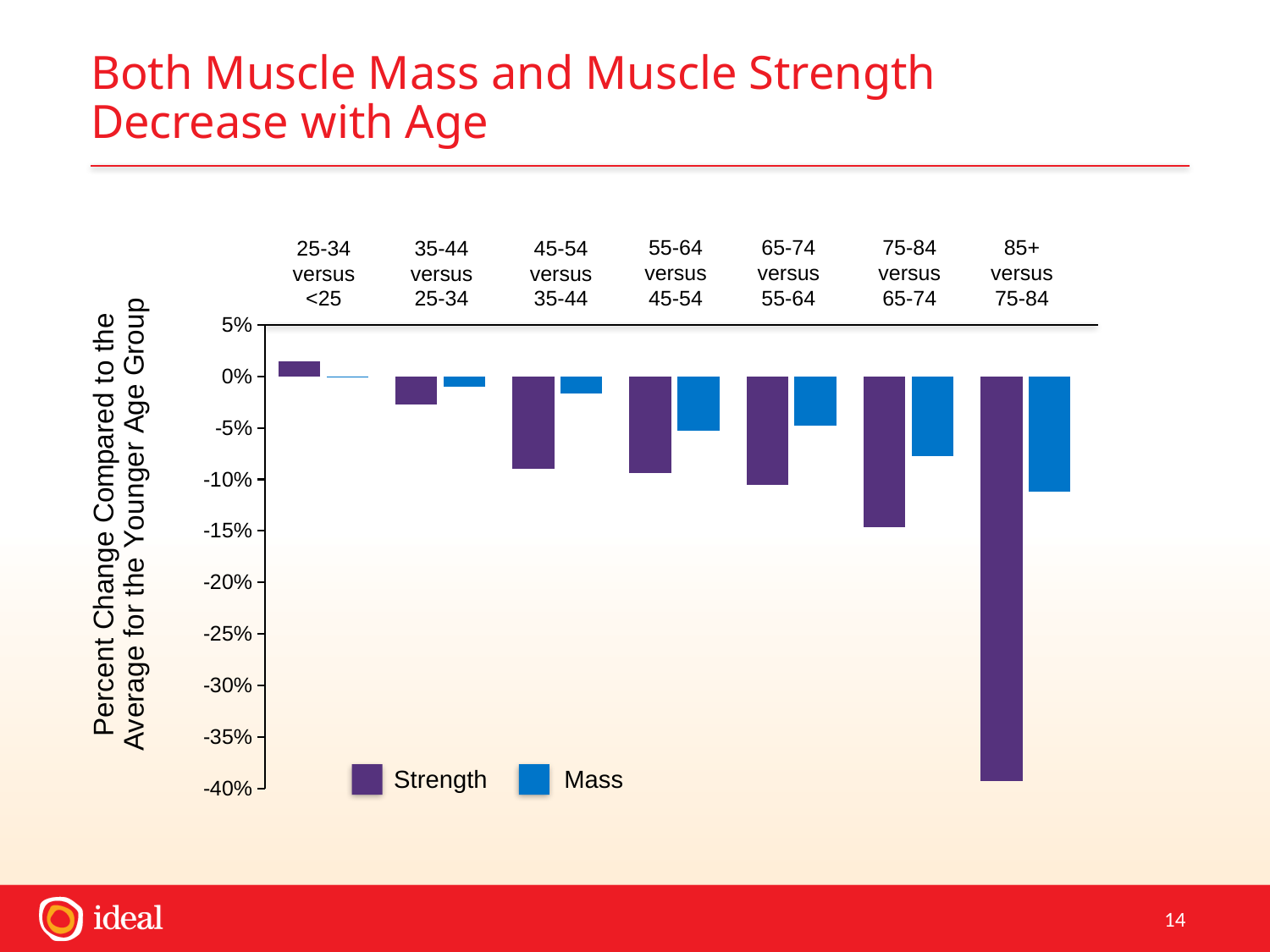
Which age-group comparison has the lowest Strength value? 85+ versus 75-84 Which age-group comparison has the lowest Mass value? 85+ versus 75-84 For 85+ versus 75-84, which series shows the larger decrease, Strength or Mass? Strength Is the Mass value for 35-44 versus 25-34 greater or less than -5%? greater Which age-group comparison has the highest Strength value? 25-34 versus <25 Is the Strength value for 85+ versus 75-84 greater or less than -35%? less What is the label on the vertical axis? Percent Change Compared to the Average for the Younger Age Group What kind of chart is shown on the slide? bar chart Is the Strength value for 75-84 versus 65-74 greater or less than -10%? less Do the Strength values generally rise or fall moving from left to right along the x axis? fall How many series does the legend list? 2 How many age-group comparisons (categories) are shown on the x axis? 7